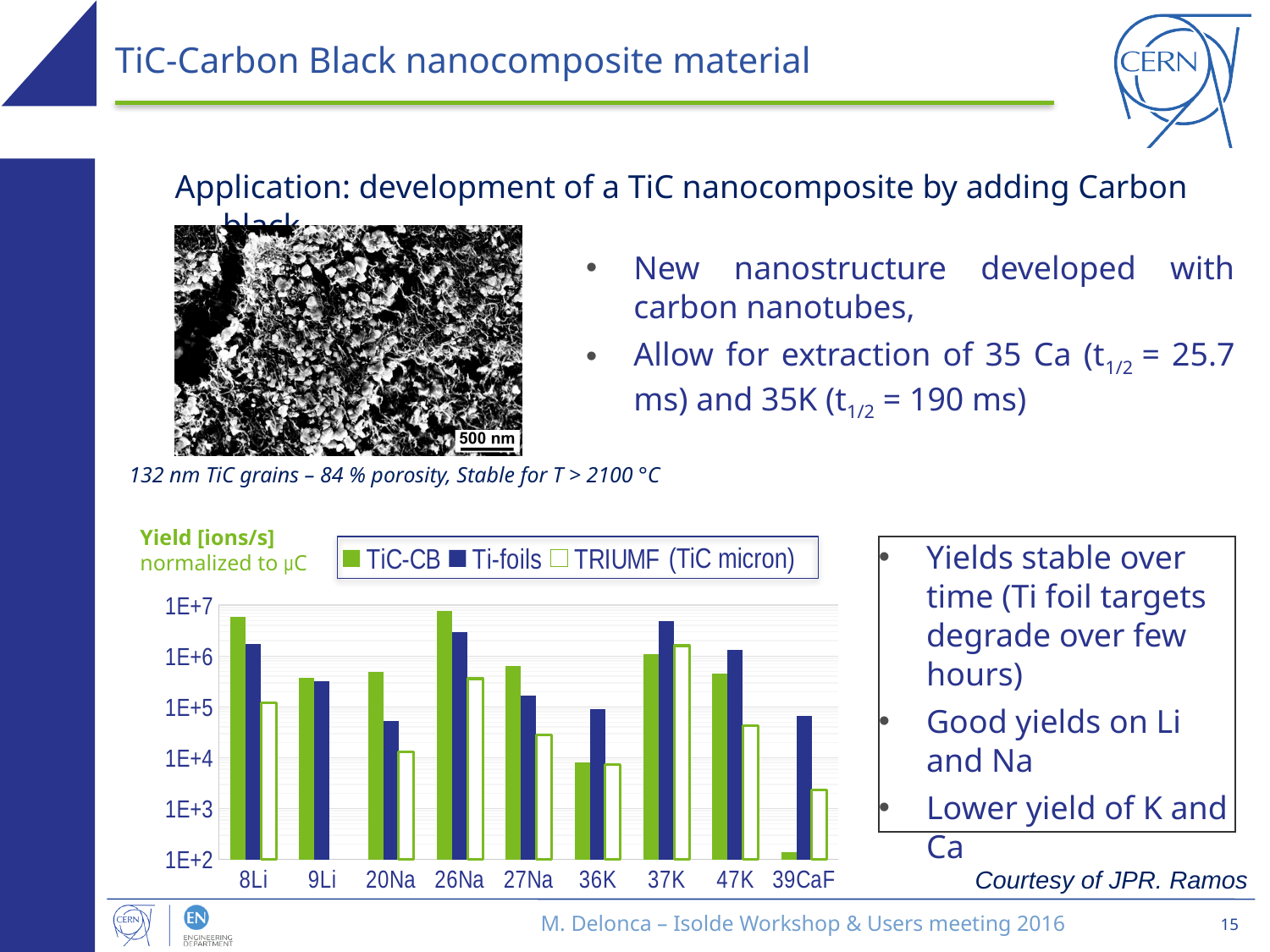
Is the TRIUMF (TiC micron) yield for 47K greater or less than 1E+5? less For 37K, which series has the higher yield: TiC-CB or Ti-foils? Ti-foils What kind of chart is shown on the slide? bar chart How many series does the chart legend list? 3 What colour represents the TiC-CB series in the chart legend? green Which isotope has the lowest TiC-CB yield in the chart? 39CaF How many isotope categories are shown on the x axis of the chart? 9 For 8Li, which series has the higher yield: TiC-CB or Ti-foils? TiC-CB Is the TiC-CB yield for 26Na greater or less than 1E+6? greater Is the Ti-foils yield for 36K greater or less than 1E+4? greater For 20Na, which series has the higher yield: TiC-CB or TRIUMF (TiC micron)? TiC-CB